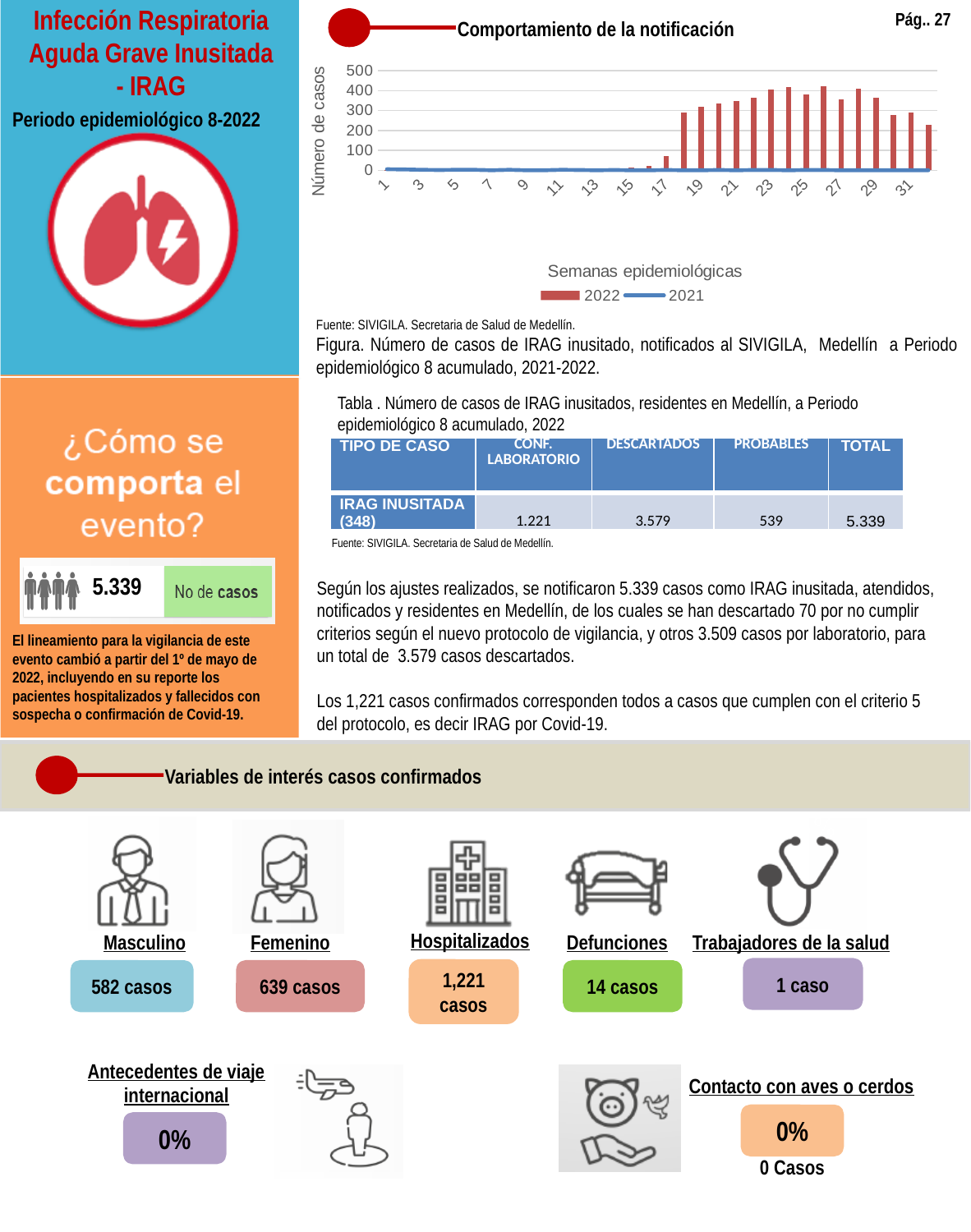
Is the 2022 value for week 17 greater or less than 100? less Is the 2022 value for week 15 greater or less than 100? less Do the 2022 values rise or fall from week 26 to week 32? fall Which two series are listed in the chart legend? 2022 and 2021 What is the title of the chart's vertical axis? Número de casos What kind of chart is used to show the 2022 notification data? bar chart Which is larger, the 2022 value for week 19 or the 2022 value for week 32? week 19 Do the 2022 values rise or fall from week 17 to week 24? rise Is the 2022 value for week 32 greater or less than 300? less How many series does the chart legend list? 2